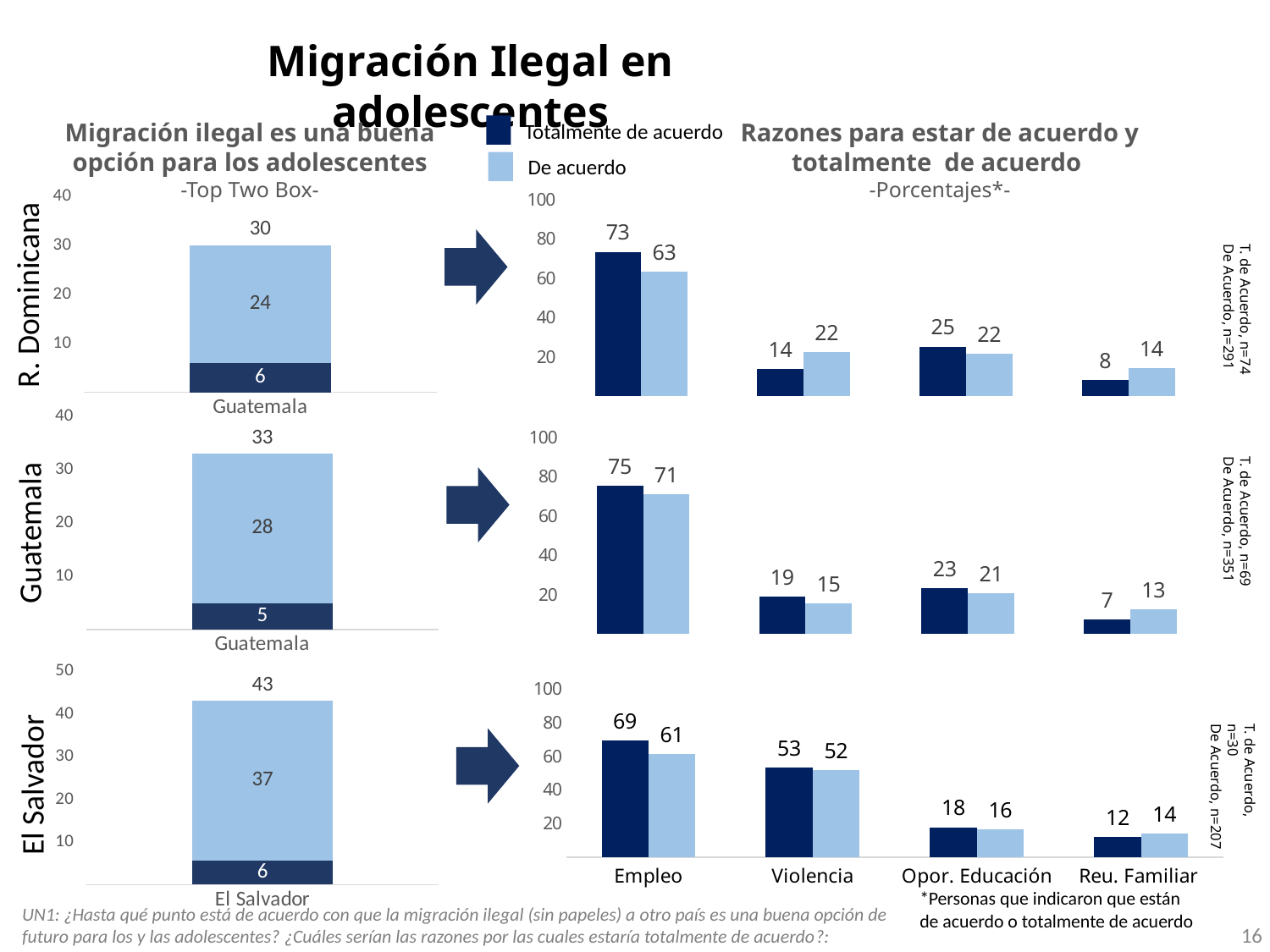
In the right-hand chart for El Salvador (Razones), what is the 'De acuerdo' value for Violencia? 52 In the stacked bar chart for Guatemala on the left, what is the total of the stacked bar? 33 What kind of chart is the left-hand chart for El Salvador (Top Two Box)? Stacked bar chart In the right-hand chart for R. Dominicana (Razones), what is the difference between the 'Totalmente de acuerdo' and 'De acuerdo' values for Empleo? 10 How many series does the legend at the top of the slide list? 2 In the right-hand chart for Guatemala (Razones), which is larger for Reu. Familiar: 'Totalmente de acuerdo' or 'De acuerdo'? De acuerdo How many reason categories are shown in the right-hand chart for El Salvador (Razones)? 4 In the right-hand chart for Guatemala (Razones), which reason has the highest values? Empleo In the right-hand chart for R. Dominicana (Razones), what is the 'Totalmente de acuerdo' value for Empleo? 73 In the right-hand chart for El Salvador (Razones), what is the 'Totalmente de acuerdo' value for Opor. Educación? 18 In the stacked bar chart for El Salvador on the left, what is the value of the 'Totalmente de acuerdo' segment? 6 In the stacked bar chart for R. Dominicana on the left, what is the value of the 'De acuerdo' segment? 24